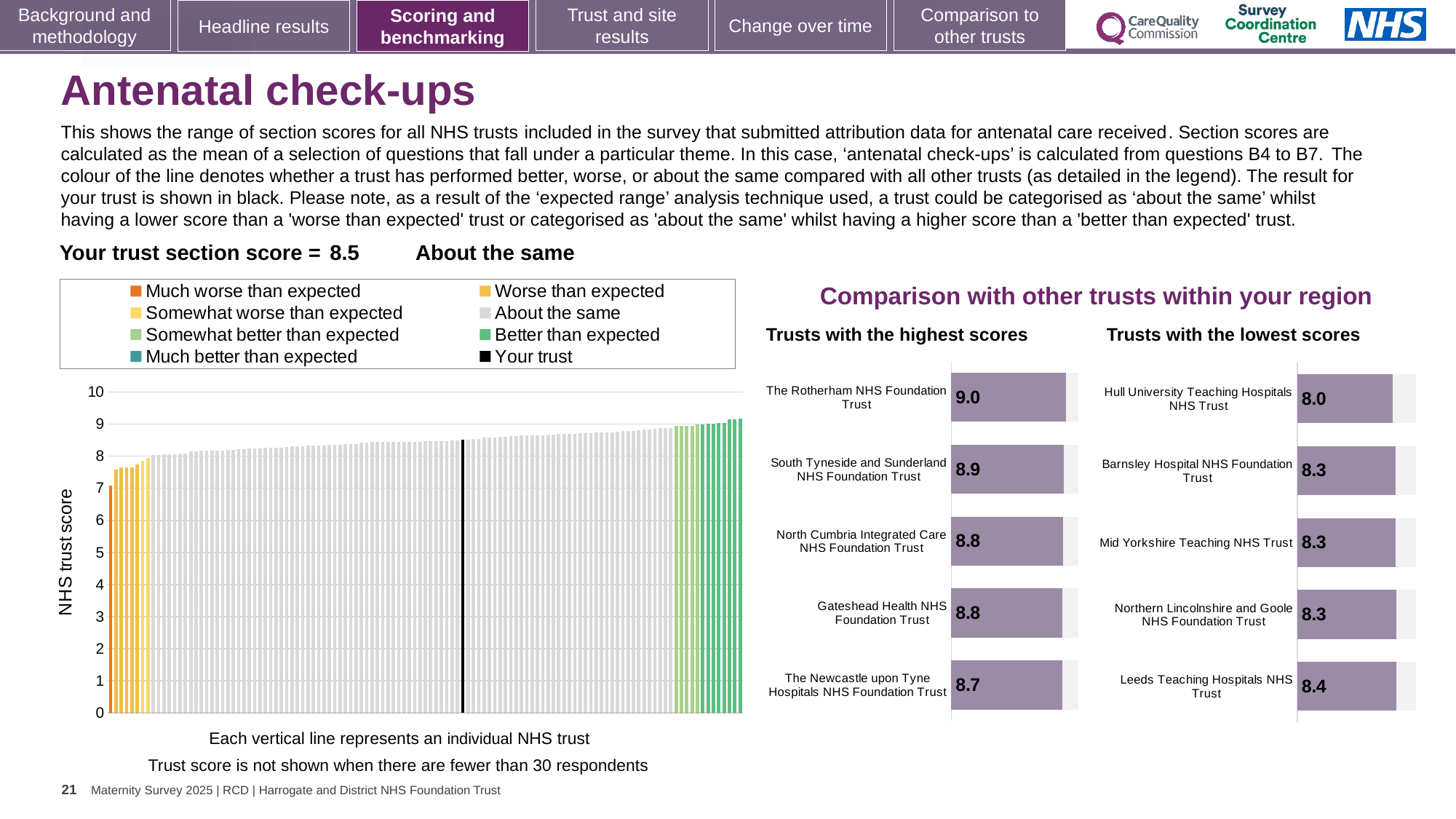
In the 'Trusts with the highest scores' chart, what is the difference between the scores of The Rotherham NHS Foundation Trust and The Newcastle upon Tyne Hospitals NHS Foundation Trust? 0.3 In the 'Trusts with the lowest scores' chart, what is the score for Barnsley Hospital NHS Foundation Trust? 8.3 In the 'Trusts with the lowest scores' chart, what is the score for Hull University Teaching Hospitals NHS Trust? 8.0 In the 'Trusts with the highest scores' chart, what is the score for The Rotherham NHS Foundation Trust? 9.0 In the 'Trusts with the lowest scores' chart, which trust has the highest score shown? Leeds Teaching Hospitals NHS Trust In the large 'NHS trust score' chart on the left, do the bar values rise or fall from left to right? Rise In the 'Trusts with the lowest scores' chart, what is the difference between the scores of Leeds Teaching Hospitals NHS Trust and Hull University Teaching Hospitals NHS Trust? 0.4 How many entries does the legend above the 'NHS trust score' chart list? 8 In the 'Trusts with the highest scores' chart, how many trusts are listed? 5 In the 'Trusts with the highest scores' chart, which trust has the lowest score shown? The Newcastle upon Tyne Hospitals NHS Foundation Trust What kind of chart is the large chart on the left with the y-axis labelled 'NHS trust score'? Bar chart In the 'Trusts with the lowest scores' chart, which has the larger score: Hull University Teaching Hospitals NHS Trust or Leeds Teaching Hospitals NHS Trust? Leeds Teaching Hospitals NHS Trust